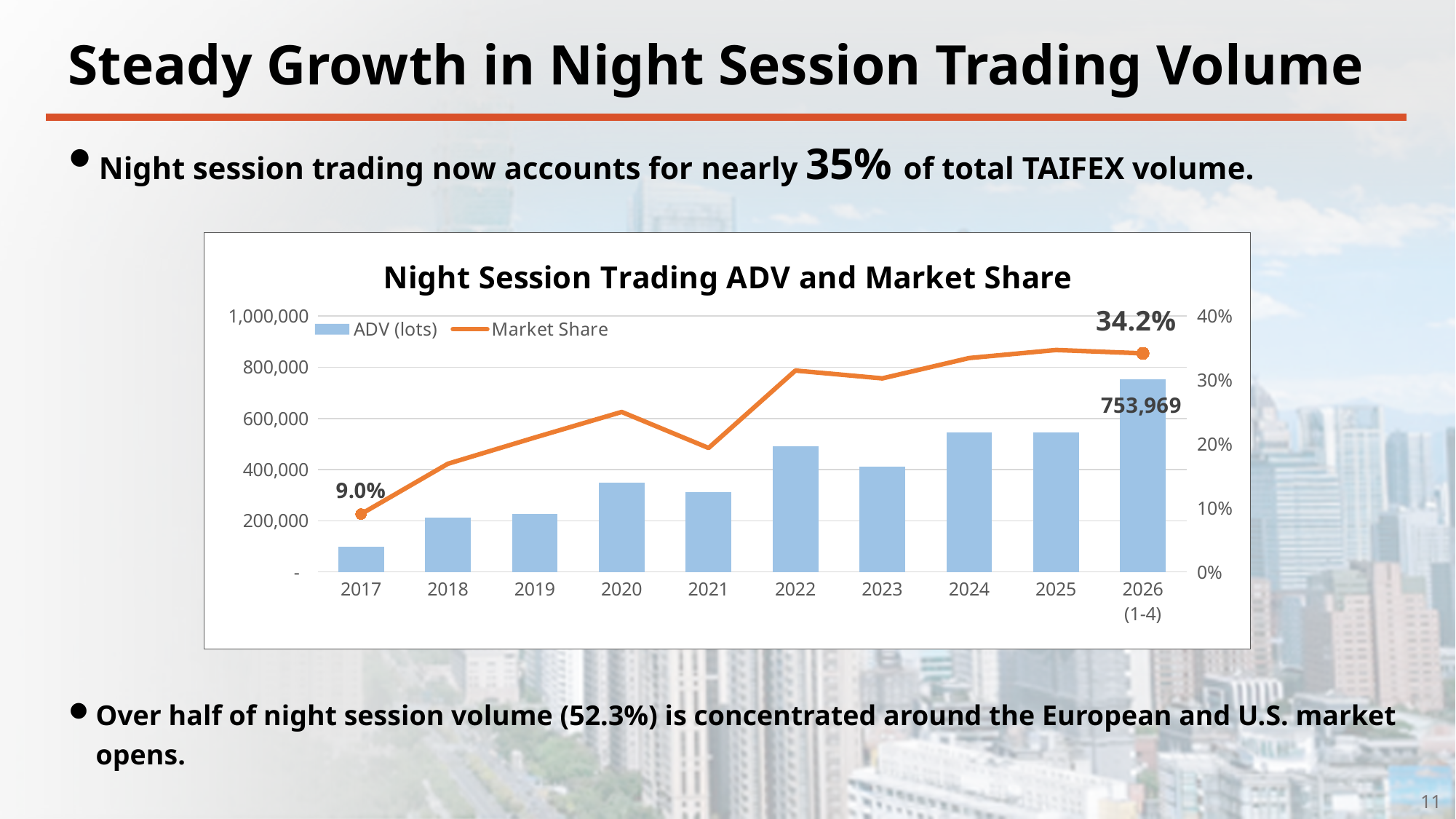
Which year has the larger ADV (lots), 2022 or 2023? 2022 How many series does the legend list? 2 What is the title of the chart? Night Session Trading ADV and Market Share Is the Market Share value for 2022 greater or less than 30%? greater Which year has the highest ADV (lots)? 2026 (1-4) Is the ADV (lots) value for 2017 greater or less than 200,000? less What market share is labelled for 2026 (1-4)? 34.2% What is the ADV (lots) value shown for 2026 (1-4)? 753,969 How many years are shown on the x axis? 10 Which year has the lowest ADV (lots)? 2017 What market share is labelled for 2017? 9.0% By how many percentage points did the market share rise from 2017 to 2026 (1-4)? 25.2 percentage points